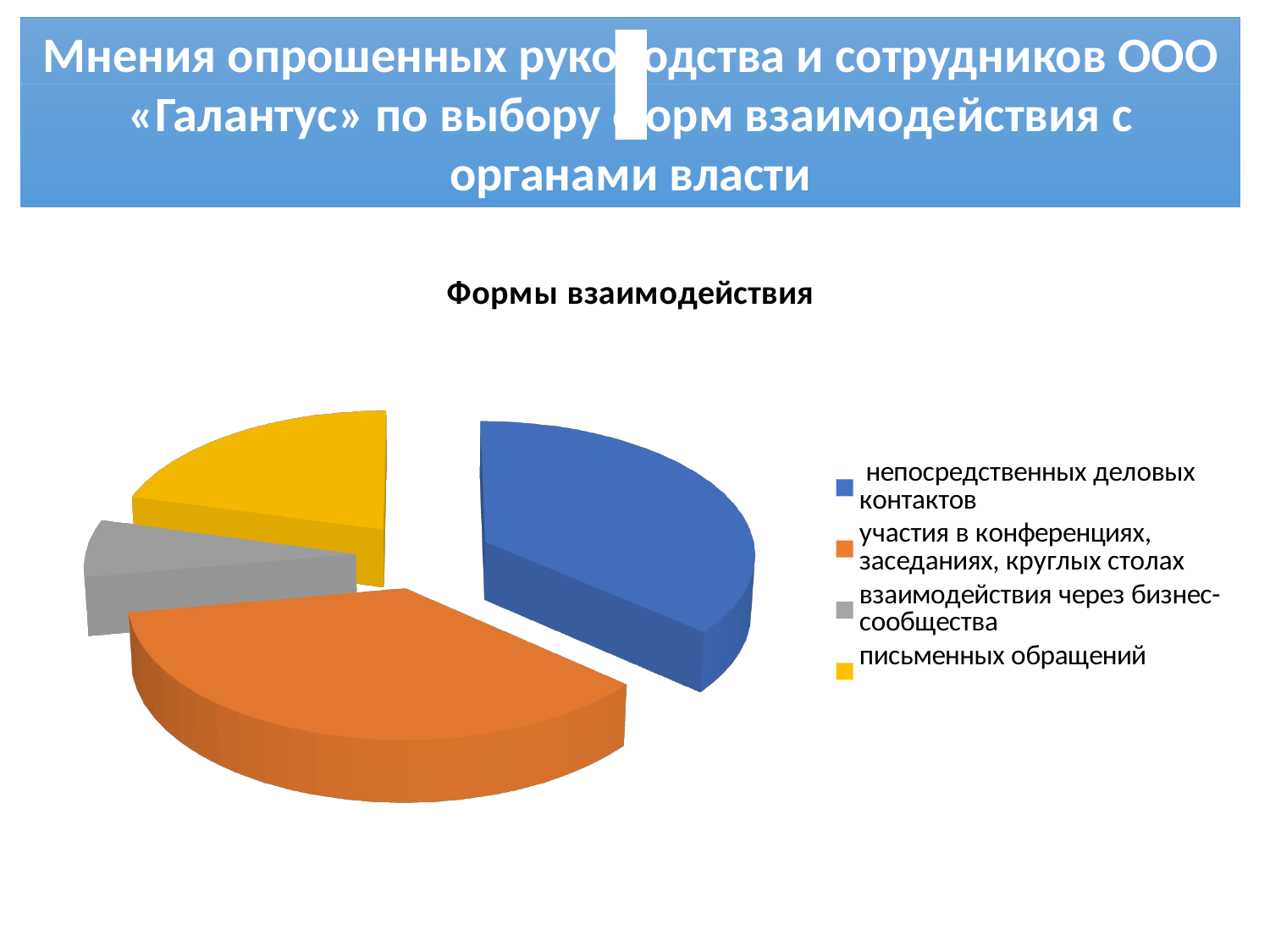
How many slices does the pie chart "Формы взаимодействия" have? 4 In the pie chart, which slice is larger: "участия в конференциях, заседаниях, круглых столах" or "письменных обращений"? участия в конференциях, заседаниях, круглых столах In the pie chart, which slice is larger: "письменных обращений" or "взаимодействия через бизнес-сообщества"? письменных обращений Which category has the smallest slice in the pie chart "Формы взаимодействия"? взаимодействия через бизнес-сообщества How many entries does the legend of the pie chart list? 4 What kind of chart is shown under the title "Формы взаимодействия"? Pie chart In the pie chart, which slice is larger: "непосредственных деловых контактов" or "письменных обращений"? непосредственных деловых контактов What is the title of the pie chart on the slide? Формы взаимодействия Which colour represents "письменных обращений" in the pie chart? Yellow